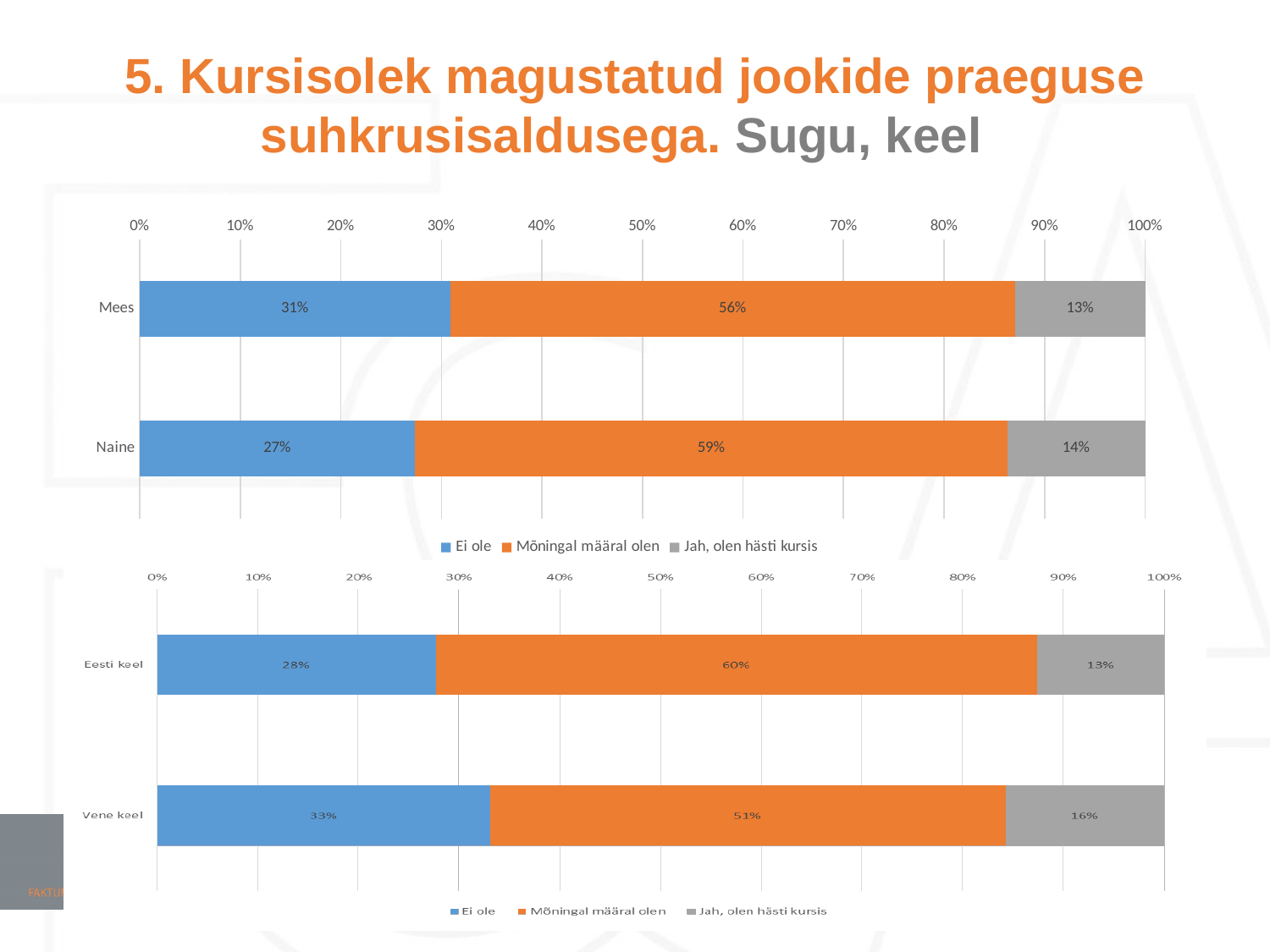
In the bottom chart, what is the value for "Jah, olen hästi kursis" for Vene keel? 16% In the top chart, what is the difference between the "Ei ole" values for Mees and Naine? 4% What kind of chart is the top chart? Stacked bar chart In the top chart, which category has the higher "Mõningal määral olen" value? Naine In the bottom chart, which category has the larger "Ei ole" value, Eesti keel or Vene keel? Vene keel In the top chart, what is the value for "Ei ole" for Mees? 31% How many categories are shown in the bottom chart? 2 In the bottom chart, which category has the lowest "Jah, olen hästi kursis" value? Eesti keel In the top chart, what is the value for "Mõningal määral olen" for Naine? 59% How many series does the legend of the top chart list? 3 In the bottom chart, what is the difference between the "Mõningal määral olen" values for Eesti keel and Vene keel? 9% In the bottom chart, what is the value for "Mõningal määral olen" for Eesti keel? 60%